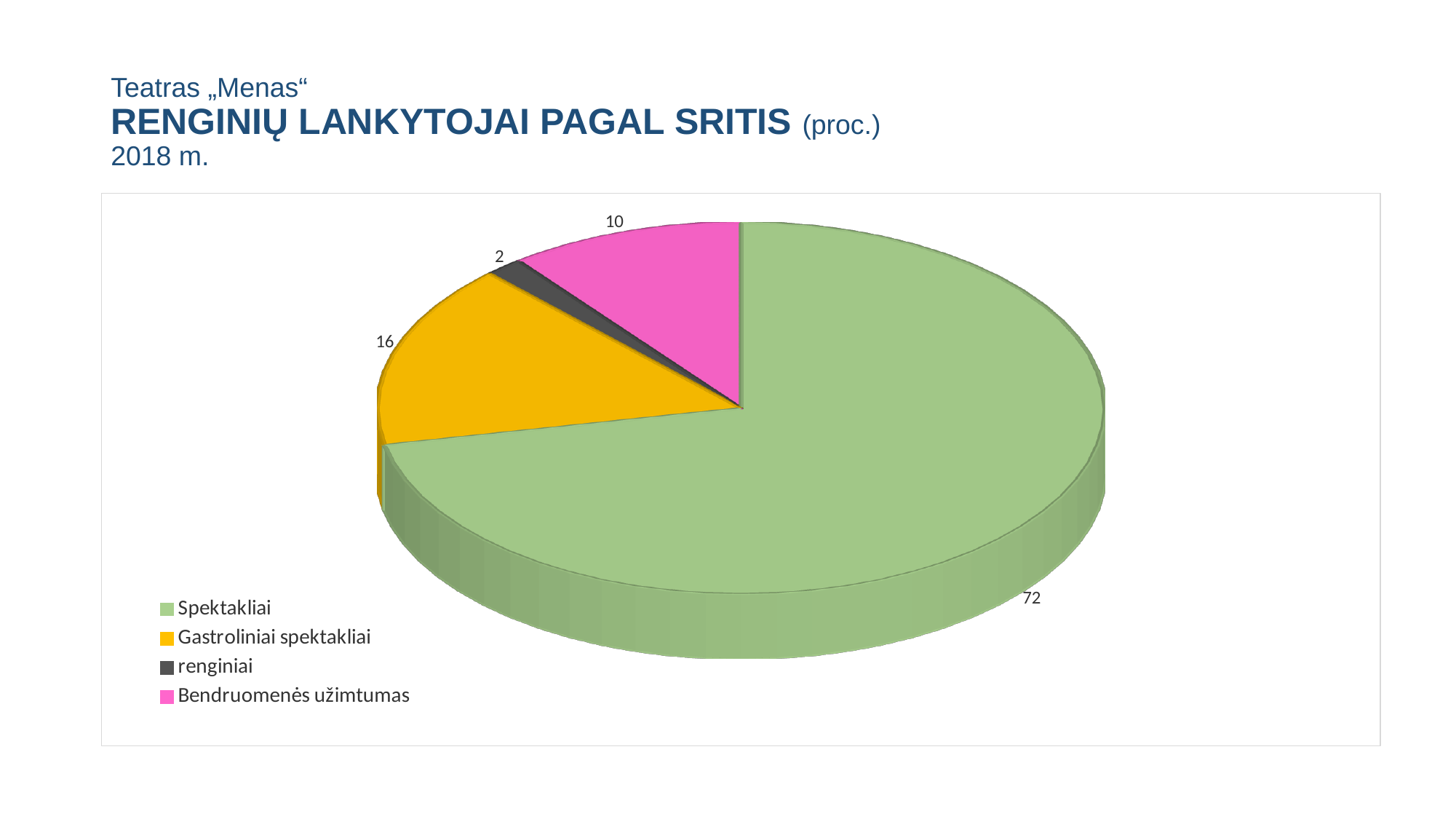
What kind of chart is shown on the slide? Pie chart What is the difference between the values for Bendruomenės užimtumas and renginiai? 8 What value is shown for renginiai? 2 Which is larger, Gastroliniai spektakliai or Bendruomenės užimtumas? Gastroliniai spektakliai What value is shown for Bendruomenės užimtumas? 10 What colour is the slice for Bendruomenės užimtumas? Pink What value is shown for Gastroliniai spektakliai? 16 Which category has the smallest slice? renginiai Which category has the largest slice? Spektakliai What is the difference between the values for Spektakliai and Gastroliniai spektakliai? 56 What value is shown for Spektakliai? 72 How many categories does the pie chart show? 4